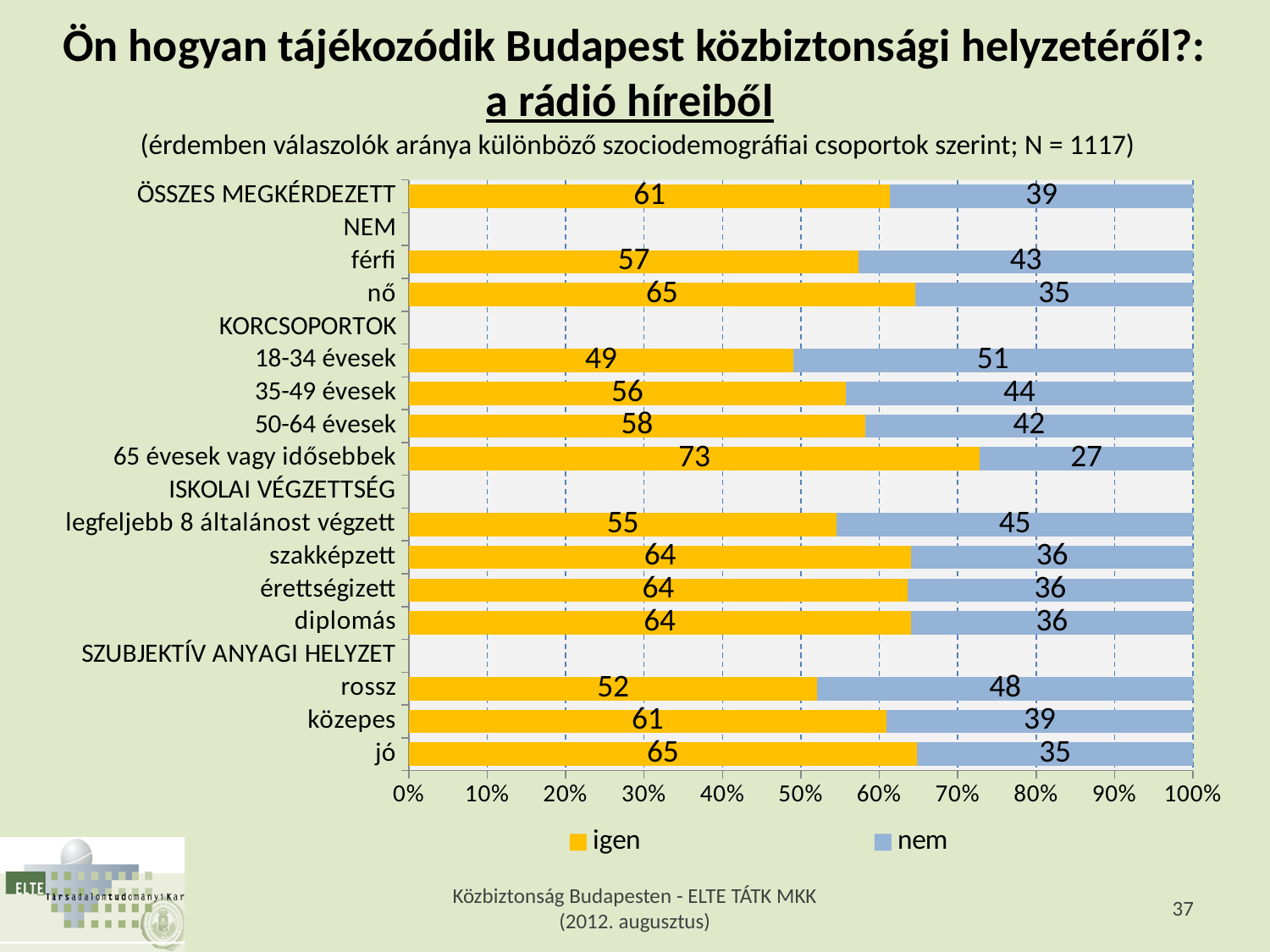
Which category has the highest 'igen' value? 65 évesek vagy idősebbek What is the difference between the 'igen' values for nő and férfi? 8 What is the 'igen' value for 65 évesek vagy idősebbek? 73 Which has a larger 'igen' value, rossz or jó? jó Which category has the lowest 'igen' value? 18-34 évesek What is the 'nem' value for 18-34 évesek? 51 How many categories have bars plotted in the chart? 14 Which colour represents the 'nem' series in the legend? blue What is the 'igen' value for ÖSSZES MEGKÉRDEZETT? 61 What kind of chart is shown on the slide? stacked bar chart What is the total of the stacked bar for diplomás? 100 How many series does the legend list? 2